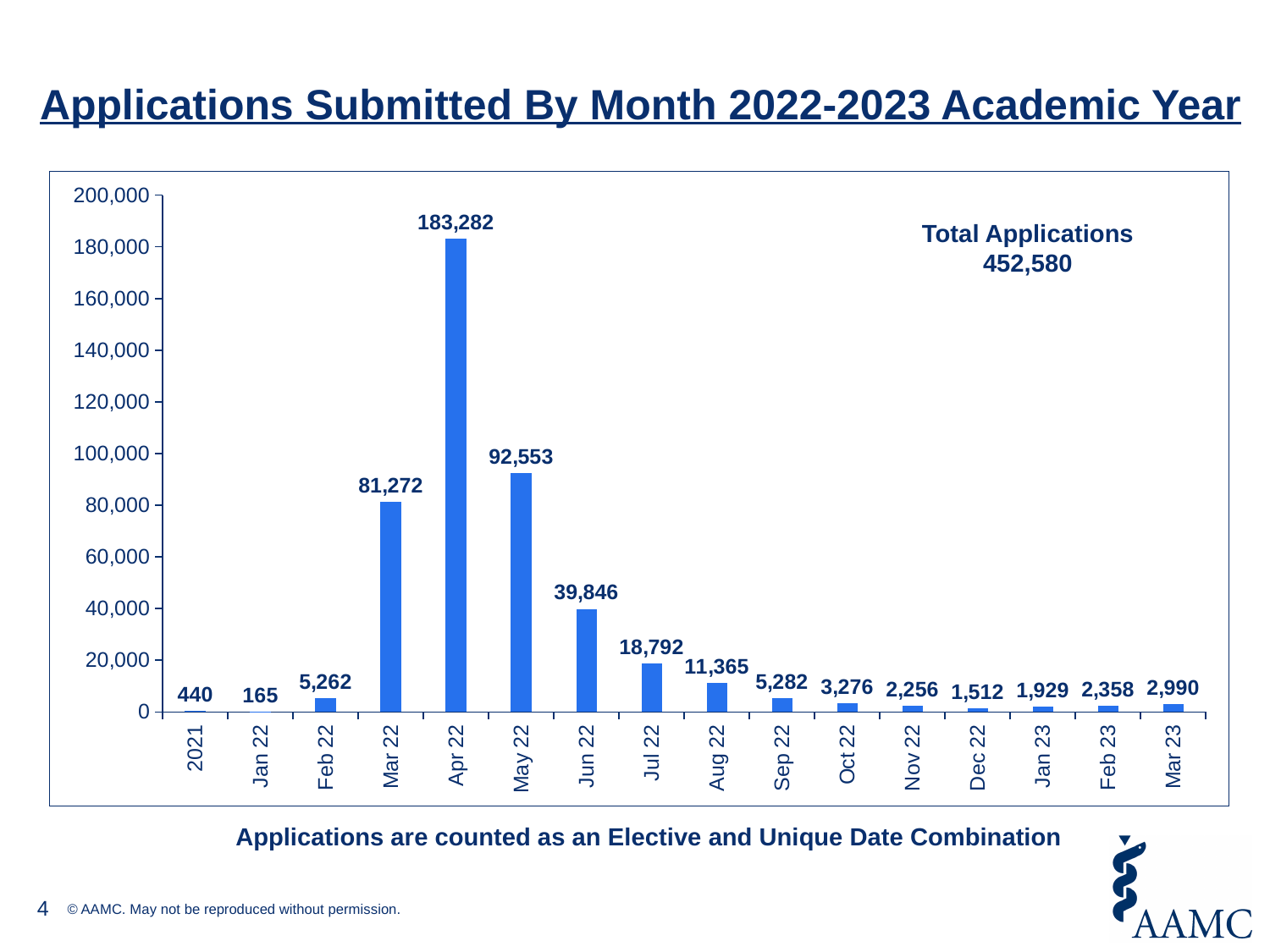
Which is larger, the value for Jul 22 or the value for Aug 22? Jul 22 How many categories are shown on the x axis? 16 Which month has the highest number of applications? Apr 22 What is the difference between the values for Apr 22 and May 22? 90,729 How many applications were submitted in Jun 22? 39,846 What kind of chart is shown on the slide? bar chart Which category has the lowest value? Jan 22 What is the difference between the values for Mar 22 and Feb 22? 76,010 What is the total number of applications stated on the chart? 452,580 What is the value shown for Dec 22? 1,512 What is the value for Apr 22? 183,282 Is the value for May 22 greater or less than 100,000? less